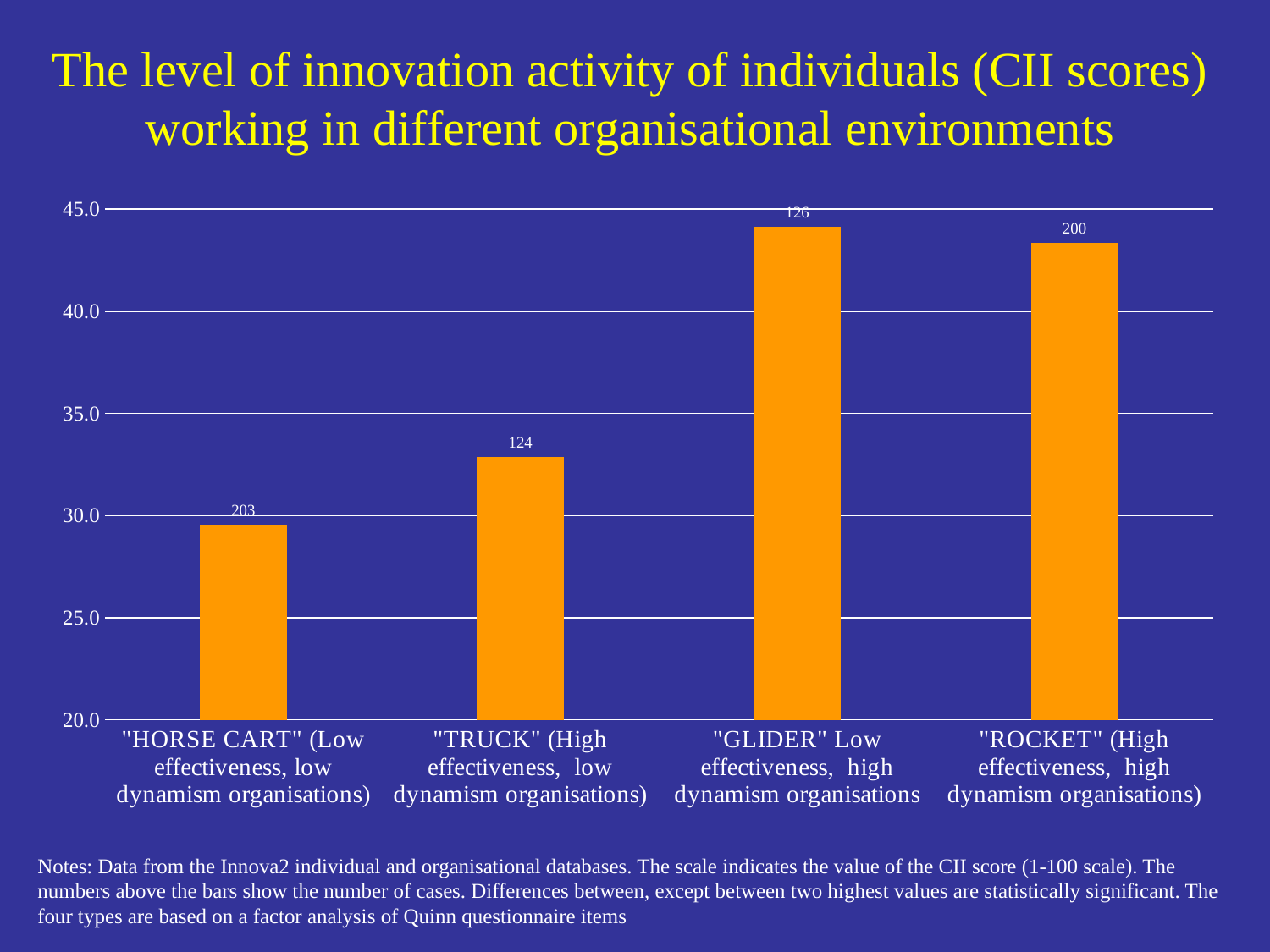
Which has a higher CII score, "TRUCK" or "HORSE CART" organisations? "TRUCK" Which organisational type has the lowest CII score in the chart? "HORSE CART" (Low effectiveness, low dynamism organisations) How many organisational types (bars) are shown in the chart? 4 What number of cases is printed above the bar for "GLIDER" organisations? 126 What number of cases is printed above the bar for "HORSE CART" organisations? 203 What is the lowest value shown on the vertical axis of the chart? 20.0 What kind of chart is shown on the slide? bar chart Do the CII scores generally rise or fall moving from left to right across the chart? rise Is the CII score for "ROCKET" organisations greater or less than 40.0? greater Is the CII score for "HORSE CART" organisations greater or less than 30.0? less Is the CII score for "GLIDER" organisations greater or less than 40.0? greater